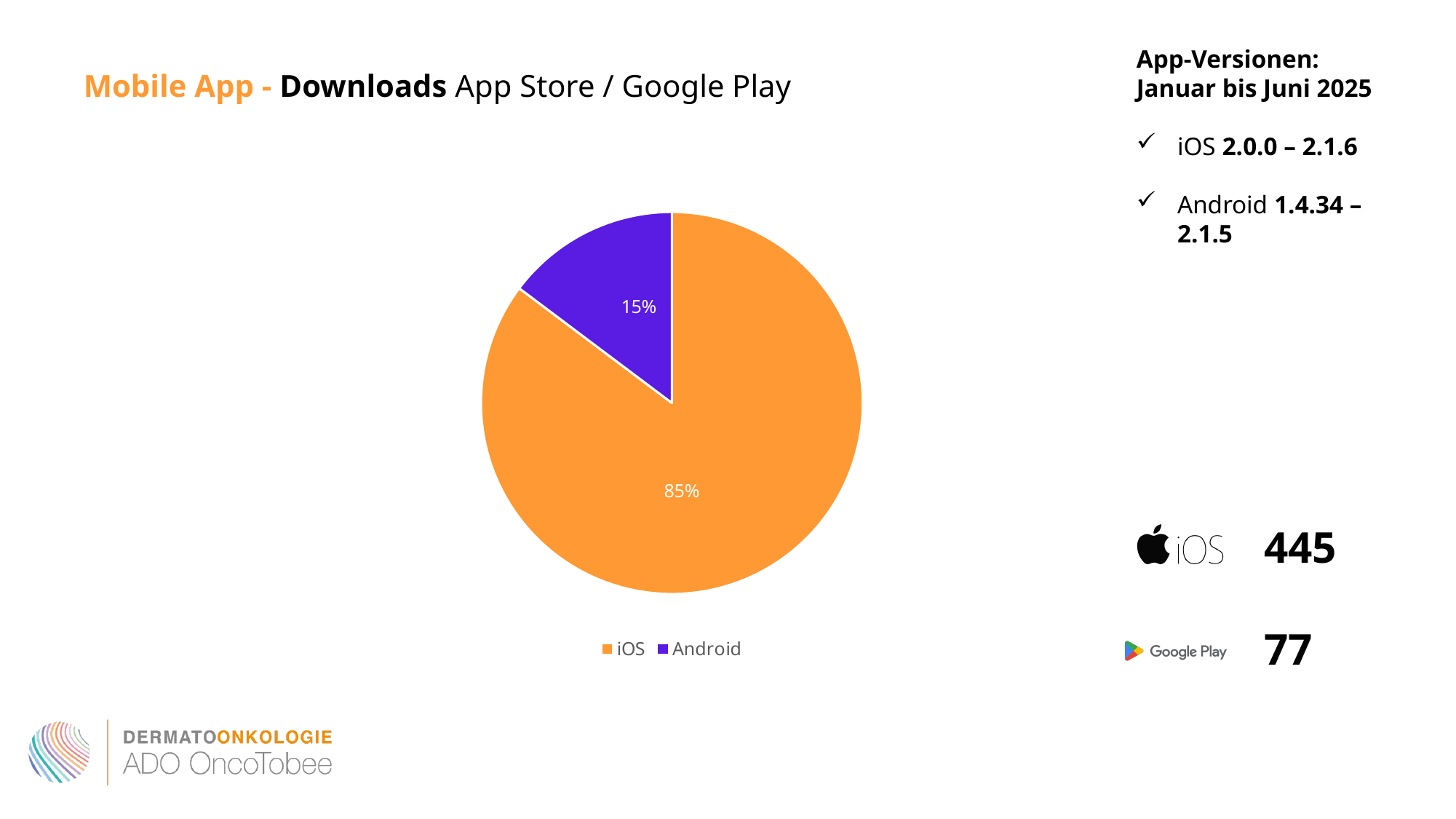
Which slice of the pie is the largest? iOS Which slice of the pie is the smallest? Android What kind of chart is shown on the slide? pie chart What colour is the Android slice? purple How many entries does the legend list? 2 Which is larger, the iOS slice or the Android slice? iOS What colour is the iOS slice? orange What share of the pie does iOS account for? 85% What share of the pie does Android account for? 15% How many slices does the pie chart have? 2 What is the difference in percentage points between the iOS and Android slices? 70